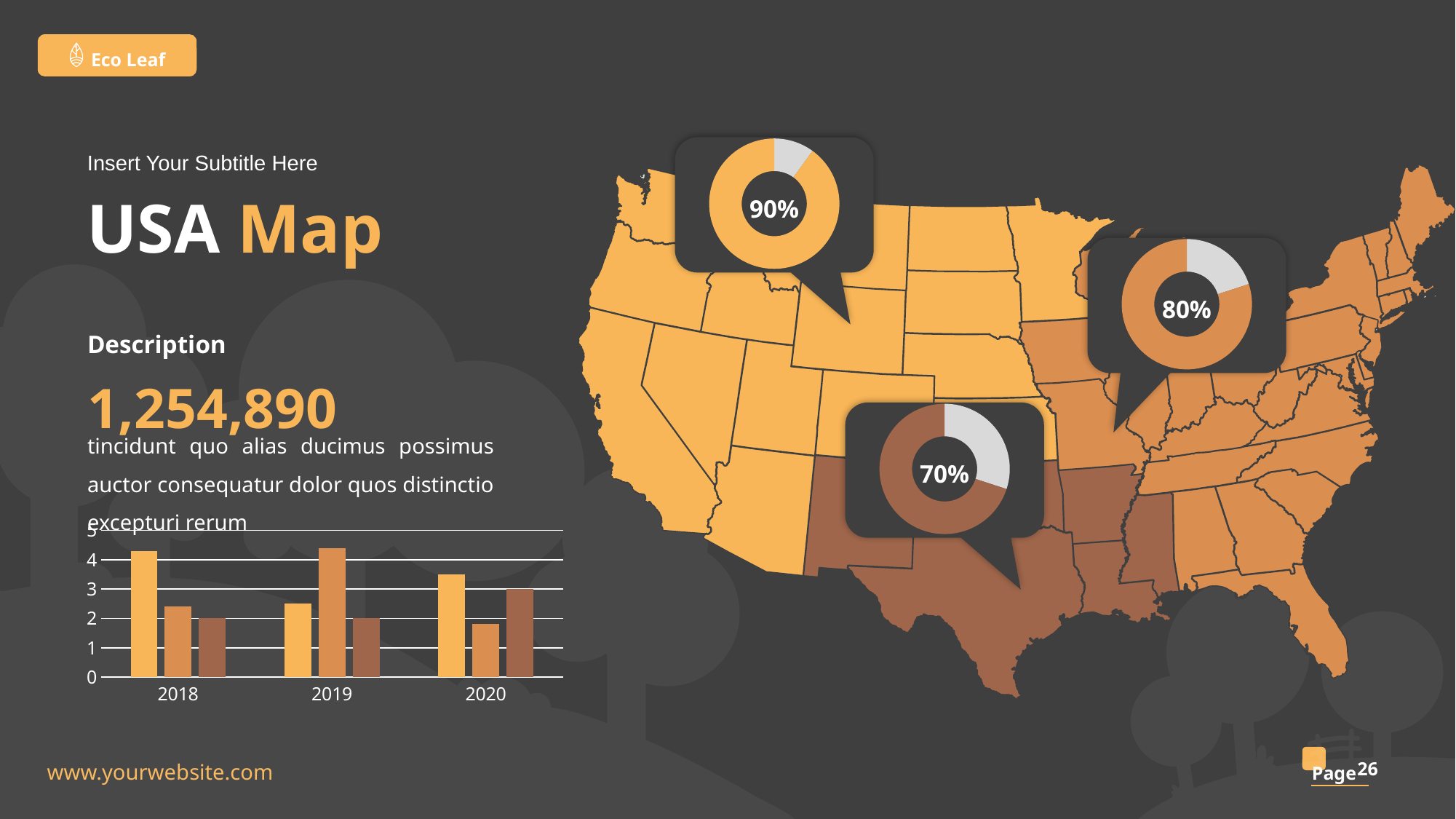
What percentage is shown in the donut chart at the top left of the map? 90% In the bar chart at the bottom left, is the value of the first (lightest) bar for 2019 greater or less than 3? less In the bar chart at the bottom left, is the value of the first (lightest) bar for 2020 greater or less than 3? greater In the bar chart at the bottom left, which is larger for 2018: the first (lightest) bar or the middle bar? the first (lightest) bar In the bar chart at the bottom left, is the value of the middle bar for 2019 greater or less than 4? greater How many year categories does the bar chart at the bottom left show? 3 In the bar chart at the bottom left, which of the three bars for 2019 is the tallest? the middle bar What percentage is shown in the donut chart on the right side of the map? 80% What percentage is shown in the donut chart in the lower centre of the map? 70% What kind of chart is shown at the bottom left of the slide? bar chart Which of the three donut charts on the map shows the highest percentage? the top-left one (90%)